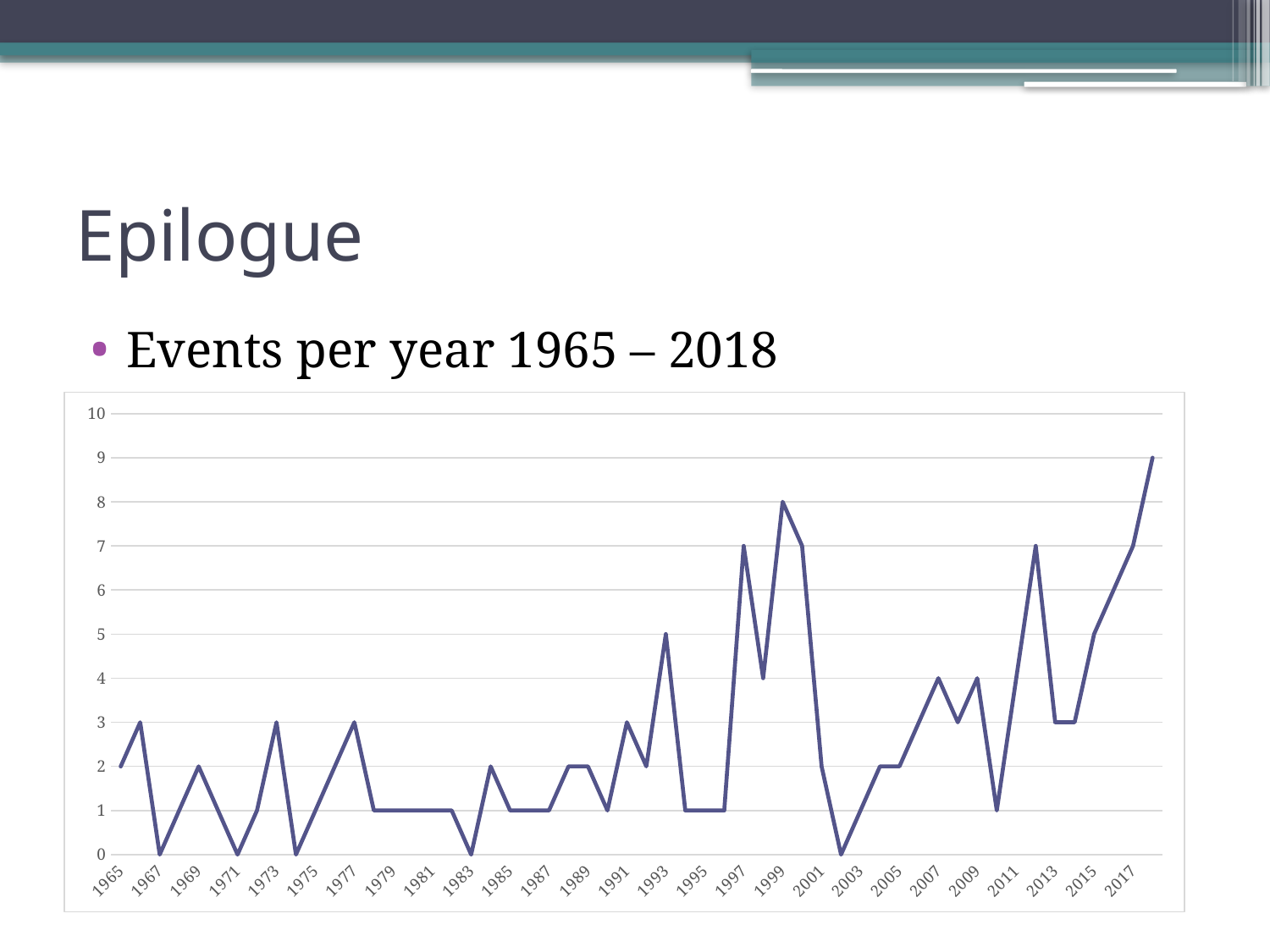
What is the value for 1997? 7 In which year does the chart reach its highest value? 2018 What is the lowest value plotted on the chart? 0 Overall, do the values rise or fall from 1965 to 2018? rise What is the value for 1993? 5 Is the value for 2012 greater or less than 5? greater What kind of chart is shown on the slide? line chart What is the difference between the value for 2018 and the value for 1965? 7 What is the value for 1999? 8 Which is larger, the value for 1999 or the value for 2001? 1999 What is the value for 1965? 2 What is the highest value plotted on the chart? 9